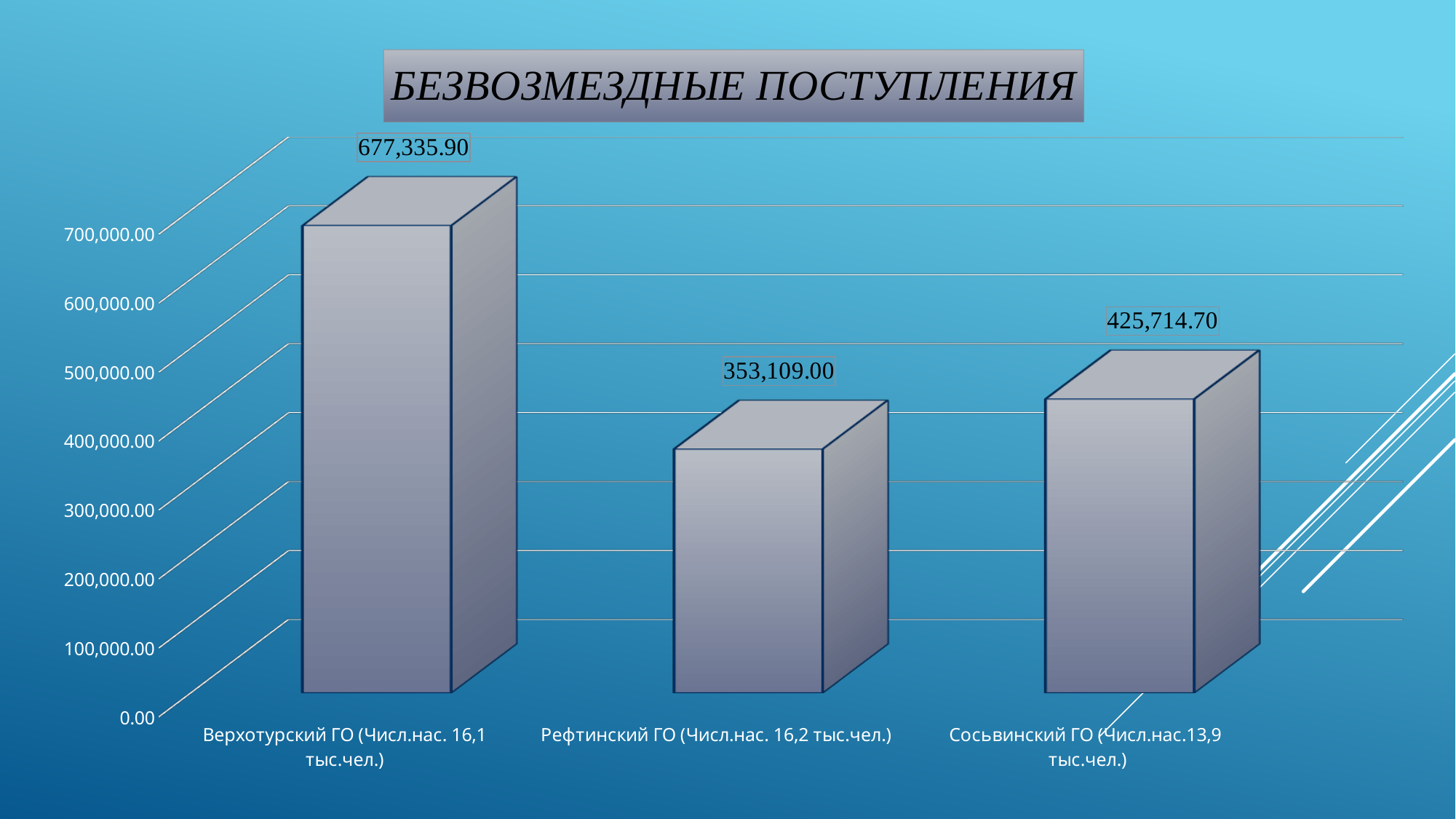
What is the value for Рефтинский ГО? 353,109.00 What is the value for Сосьвинский ГО? 425,714.70 How many categories are shown in the chart? 3 What is the value for Верхотурский ГО? 677,335.90 What is the difference between the values for Сосьвинский ГО and Рефтинский ГО? 72,605.70 Is the value for Рефтинский ГО greater or less than 400,000.00? less Which is larger, the value for Сосьвинский ГО or the value for Рефтинский ГО? Сосьвинский ГО What is the title of the chart? БЕЗВОЗМЕЗДНЫЕ ПОСТУПЛЕНИЯ What kind of chart is shown on the slide? bar chart Which category has the lowest value? Рефтинский ГО What is the difference between the values for Верхотурский ГО and Рефтинский ГО? 324,226.90 Which category has the highest value? Верхотурский ГО